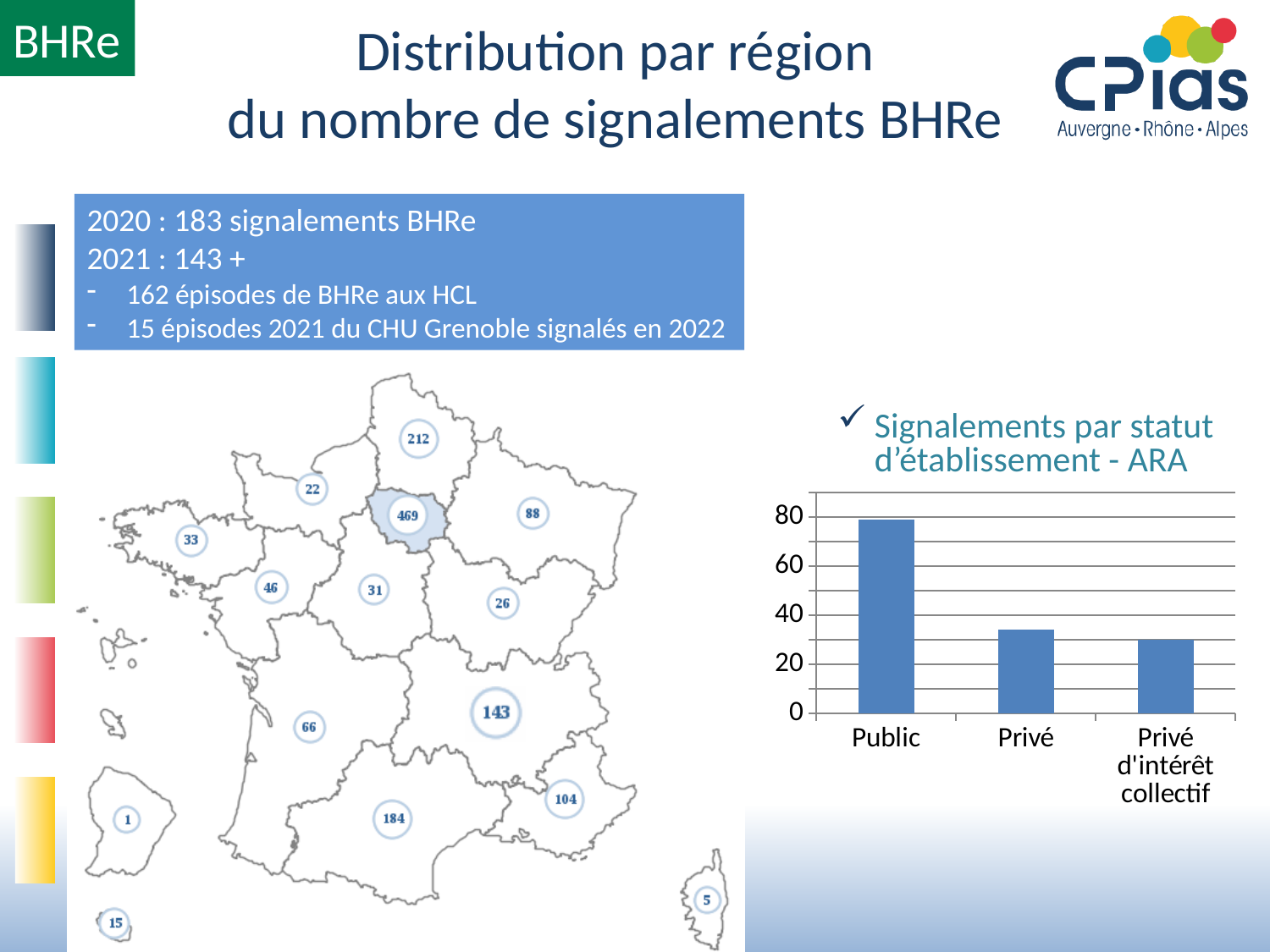
How many categories are shown on the x axis of the bar chart? 3 In the bar chart, is the value for Privé greater or less than 40? less What is the title written above the bar chart? Signalements par statut d'établissement - ARA What is the highest tick value shown on the y axis of the bar chart? 80 What kind of chart is shown under the heading 'Signalements par statut d'établissement - ARA'? bar chart In the bar chart, which is larger, the value for Public or the value for Privé? Public In the bar chart, is the value for Privé d'intérêt collectif greater or less than 20? greater In the bar chart, is the value for Public greater or less than 60? greater Do the bar values rise or fall from left to right across the x axis of the bar chart? fall Which category has the highest bar in the bar chart? Public Which category has the lowest bar in the bar chart? Privé d'intérêt collectif